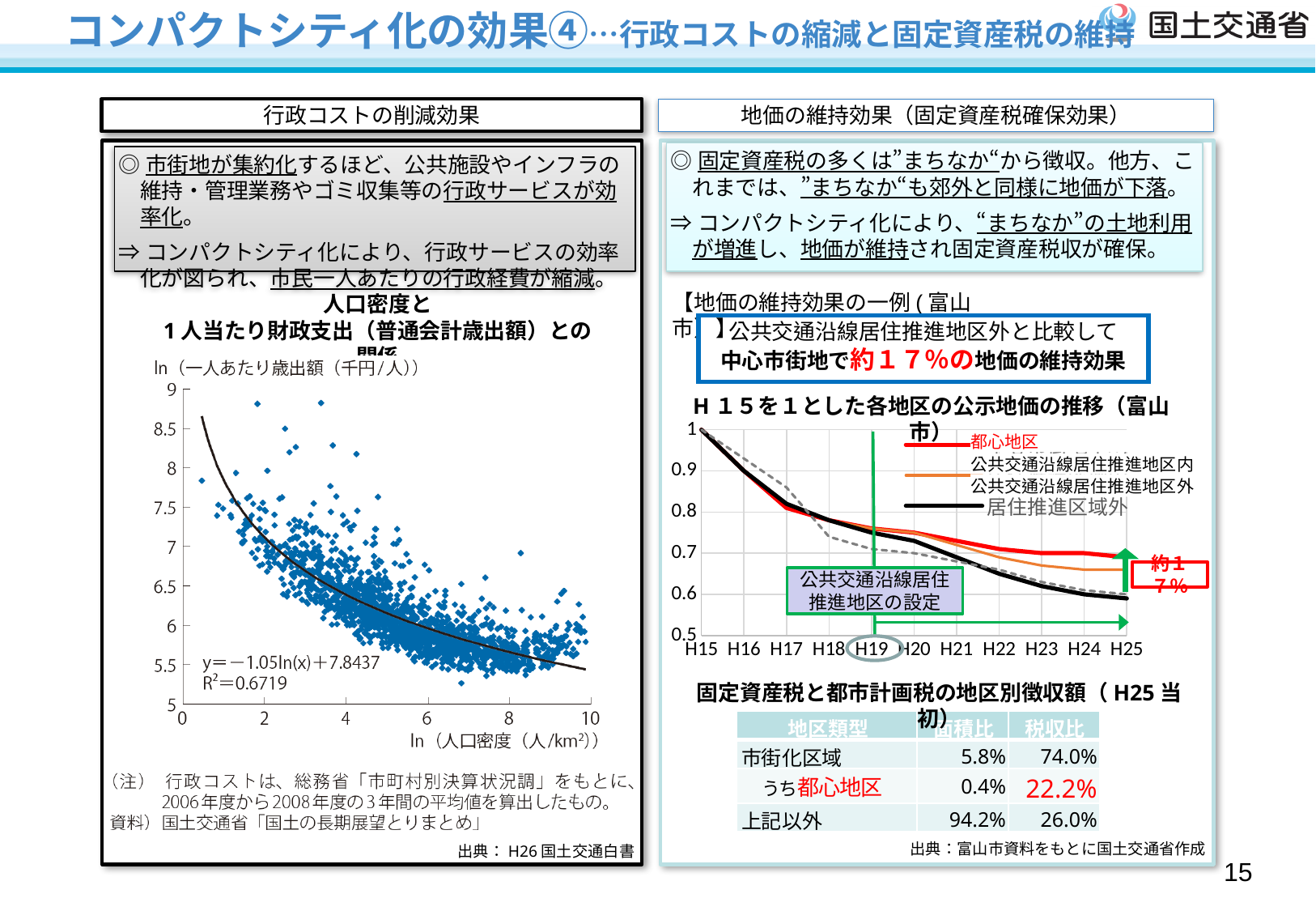
In the right line chart Ｈ１５を１とした各地区の公示地価の推移, is the value for 公共交通沿線居住推進地区外 at H25 greater or less than 0.7? less In the right line chart Ｈ１５を１とした各地区の公示地価の推移, which is larger at H25: 都心地区 or 公共交通沿線居住推進地区外? 都心地区 In the left scatter chart, what is the regression equation printed on the chart? y=−1.05ln(x)+7.8437 In the right line chart Ｈ１５を１とした各地区の公示地価の推移, which series has the highest value at H25? 都心地区 In the right line chart Ｈ１５を１とした各地区の公示地価の推移, what is the value of every series at H15? 1 In the left scatter chart, what is the R² value printed on the chart? R²=0.6719 In the left scatter chart, does per-capita expenditure (ln 一人あたり歳出額) rise or fall as ln population density increases along the x axis? fall What kind of chart is the right chart titled Ｈ１５を１とした各地区の公示地価の推移（富山市）? line chart In the right line chart Ｈ１５を１とした各地区の公示地価の推移, do the land price index values rise or fall from H15 to H25? fall In the right line chart Ｈ１５を１とした各地区の公示地価の推移, how many years are shown on the x axis? 11 In the right line chart Ｈ１５を１とした各地区の公示地価の推移, is the value for 都心地区 at H25 greater or less than 0.6? greater What kind of chart is the left chart titled 人口密度と１人当たり財政支出（普通会計歳出額）との関係? scatter plot